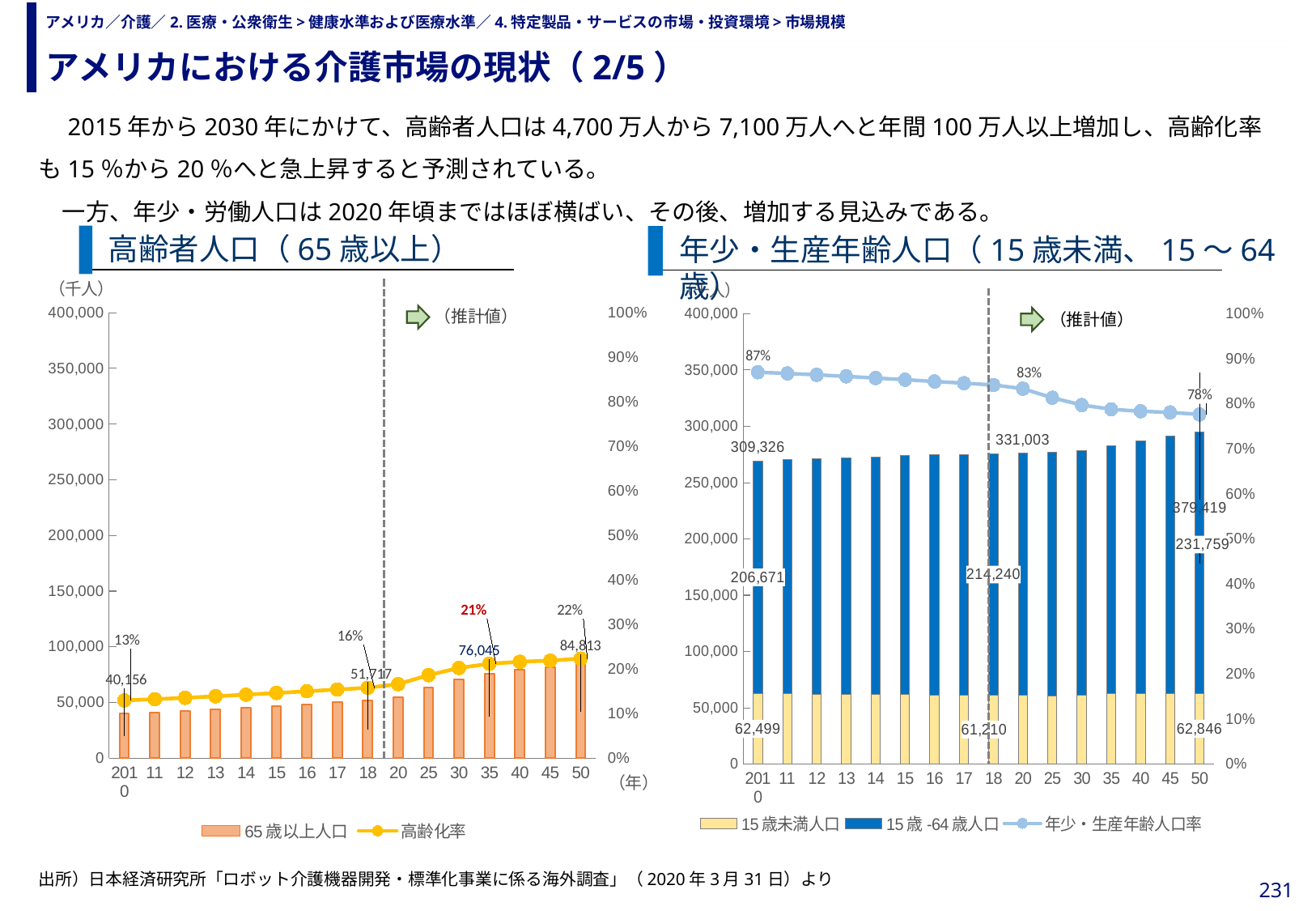
In the right chart (年少・生産年齢人口), what is the difference between the 15歳-64歳人口 values for 2050 and 2010? 25,088 In the left chart (高齢者人口（65歳以上）), what is the 高齢化率 for 2035? 21% In the right chart (年少・生産年齢人口), what is the value of 15歳未満人口 for 2018? 61,210 In the left chart (高齢者人口（65歳以上）), what is the 高齢化率 for 2050? 22% In the left chart (高齢者人口（65歳以上）), what is the difference between the 65歳以上人口 values for 2050 and 2010? 44,657 In the left chart (高齢者人口（65歳以上）), what is the value of 65歳以上人口 for 2010? 40,156 In the left chart (高齢者人口（65歳以上）), how many year categories are shown on the x axis? 16 How many series does the legend of the right chart (年少・生産年齢人口) list? 3 In the left chart (高齢者人口（65歳以上）), does the 高齢化率 line rise or fall from 2010 to 2050? rise In the right chart (年少・生産年齢人口), what is the value of 15歳-64歳人口 for 2050? 231,759 In the right chart (年少・生産年齢人口), what is the 年少・生産年齢人口率 for 2010? 87% In the left chart (高齢者人口（65歳以上）), is the 65歳以上人口 value for 2030 greater or less than 50,000? greater